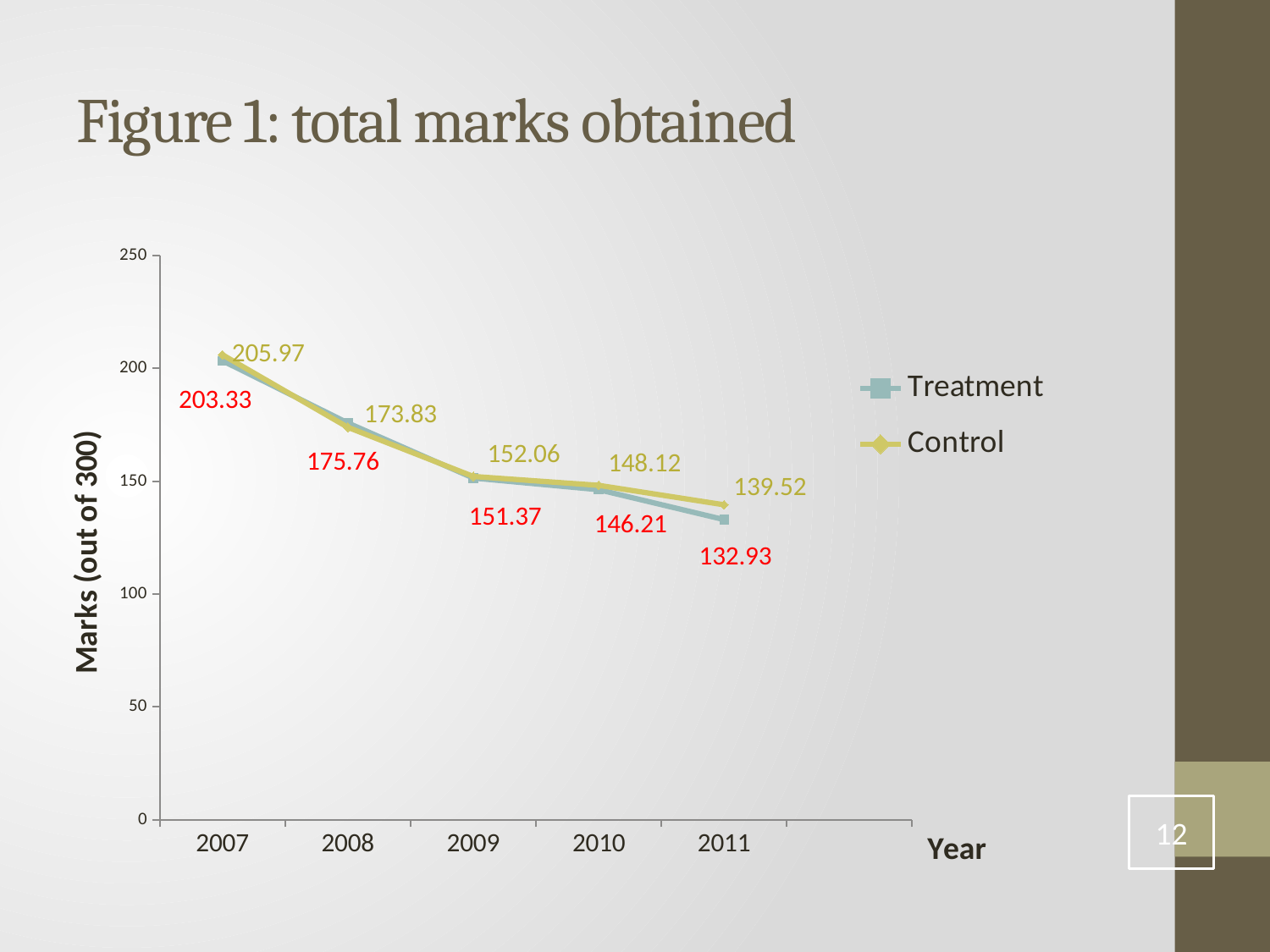
What is the Control value for 2009? 152.06 Do the Treatment values rise or fall from 2007 to 2011? Fall Which is larger in 2008, the Treatment value or the Control value? Treatment What is the Treatment value for 2010? 146.21 How many series does the legend list? 2 In which year is the Treatment series lowest? 2011 In which year is the Control series highest? 2007 What is the difference between the Control and Treatment values in 2011? 6.59 How many years are shown on the x axis? 5 What is the Treatment value for 2007? 203.33 What is the Control value for 2011? 139.52 What kind of chart is shown? Line chart